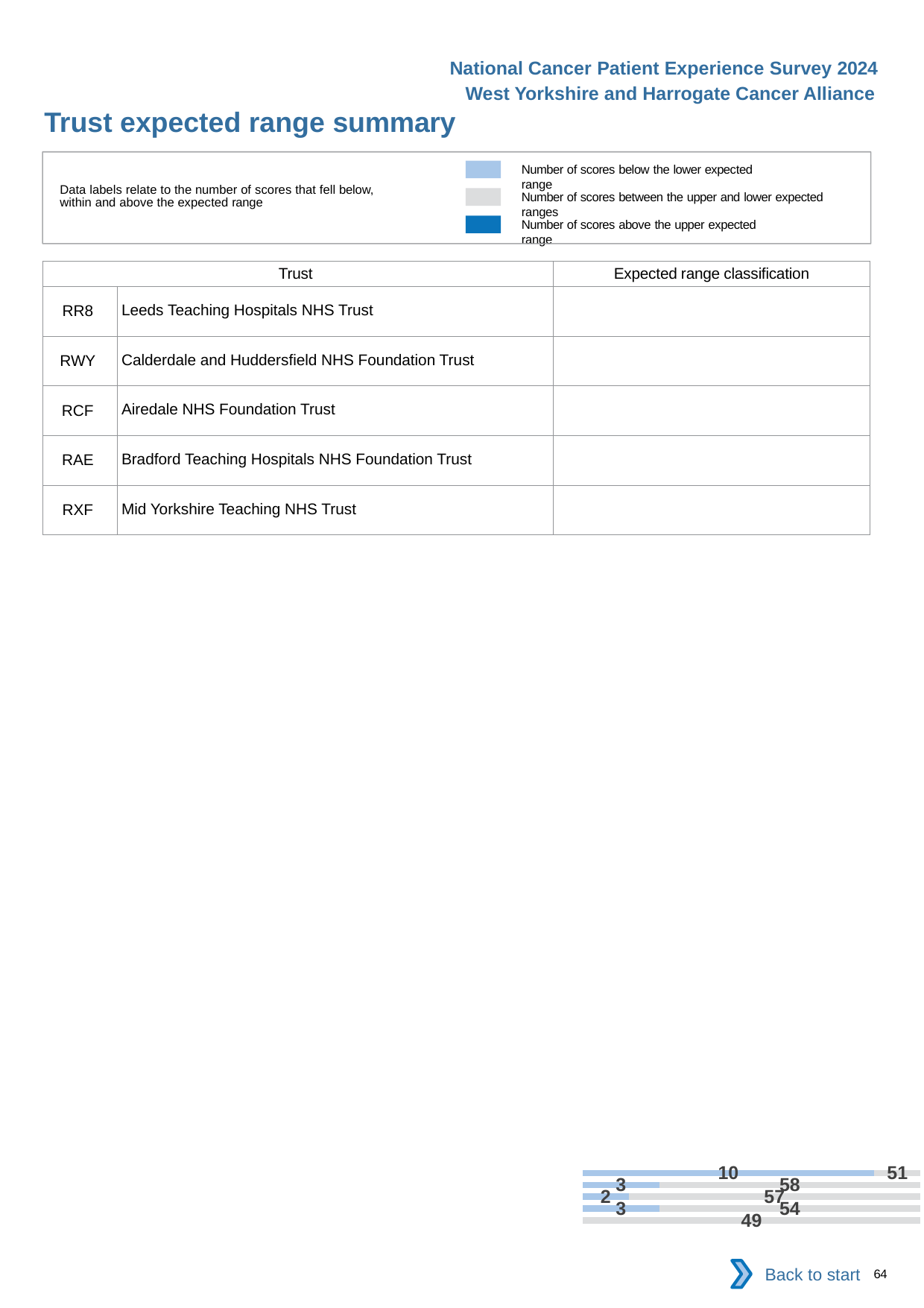
In the stacked bar chart at the bottom right, what is the total of the fourth bar from the top (3 and 54)? 57 In the stacked bar chart at the bottom right, what is the value of the grey segment in the second bar from the top? 58 In the stacked bar chart at the bottom right, what is the value of the grey segment in the top bar? 51 What kind of chart is shown at the bottom right of the slide? Bar chart How many bars are in the stacked bar chart at the bottom right of the slide? 5 According to the legend, what does the light blue colour represent? Number of scores below the lower expected range In the stacked bar chart at the bottom right, what is the value shown on the bottom bar? 49 In the stacked bar chart at the bottom right, what is the difference between the grey segment of the second bar (58) and the grey segment of the top bar (51)? 7 In the stacked bar chart at the bottom right, what is the value of the light blue segment in the top bar? 10 In the stacked bar chart at the bottom right, what is the value of the light blue segment in the third bar from the top? 2 In the stacked bar chart at the bottom right, which bar has the largest light blue segment? The top bar (10) In the stacked bar chart at the bottom right, what is the total of the top bar (10 and 51)? 61